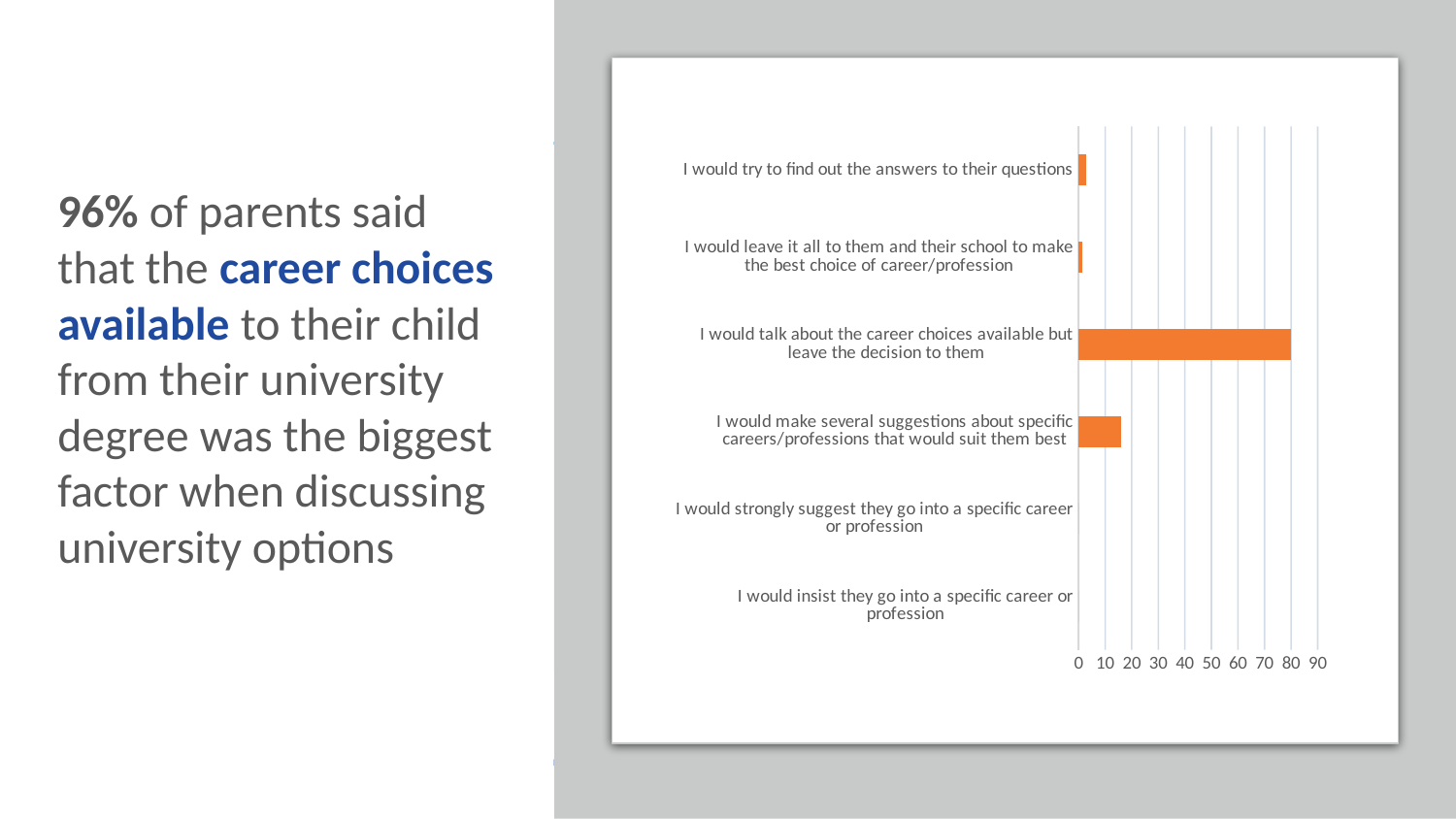
What colour are the bars in the chart? orange Which is larger: the value for "I would make several suggestions about specific careers/professions that would suit them best" or the value for "I would try to find out the answers to their questions"? I would make several suggestions about specific careers/professions that would suit them best What is the highest tick value shown on the chart's value axis? 90 Is the value for "I would talk about the career choices available but leave the decision to them" greater or less than 70? greater Is the value for "I would make several suggestions about specific careers/professions that would suit them best" greater or less than 30? less What kind of chart is shown on the slide? bar chart Which category has the highest value on the chart? I would talk about the career choices available but leave the decision to them Is the value for "I would leave it all to them and their school to make the best choice of career/profession" greater or less than 10? less Which is larger: the value for "I would talk about the career choices available but leave the decision to them" or the value for "I would make several suggestions about specific careers/professions that would suit them best"? I would talk about the career choices available but leave the decision to them How many categories (response options) are shown on the chart? 6